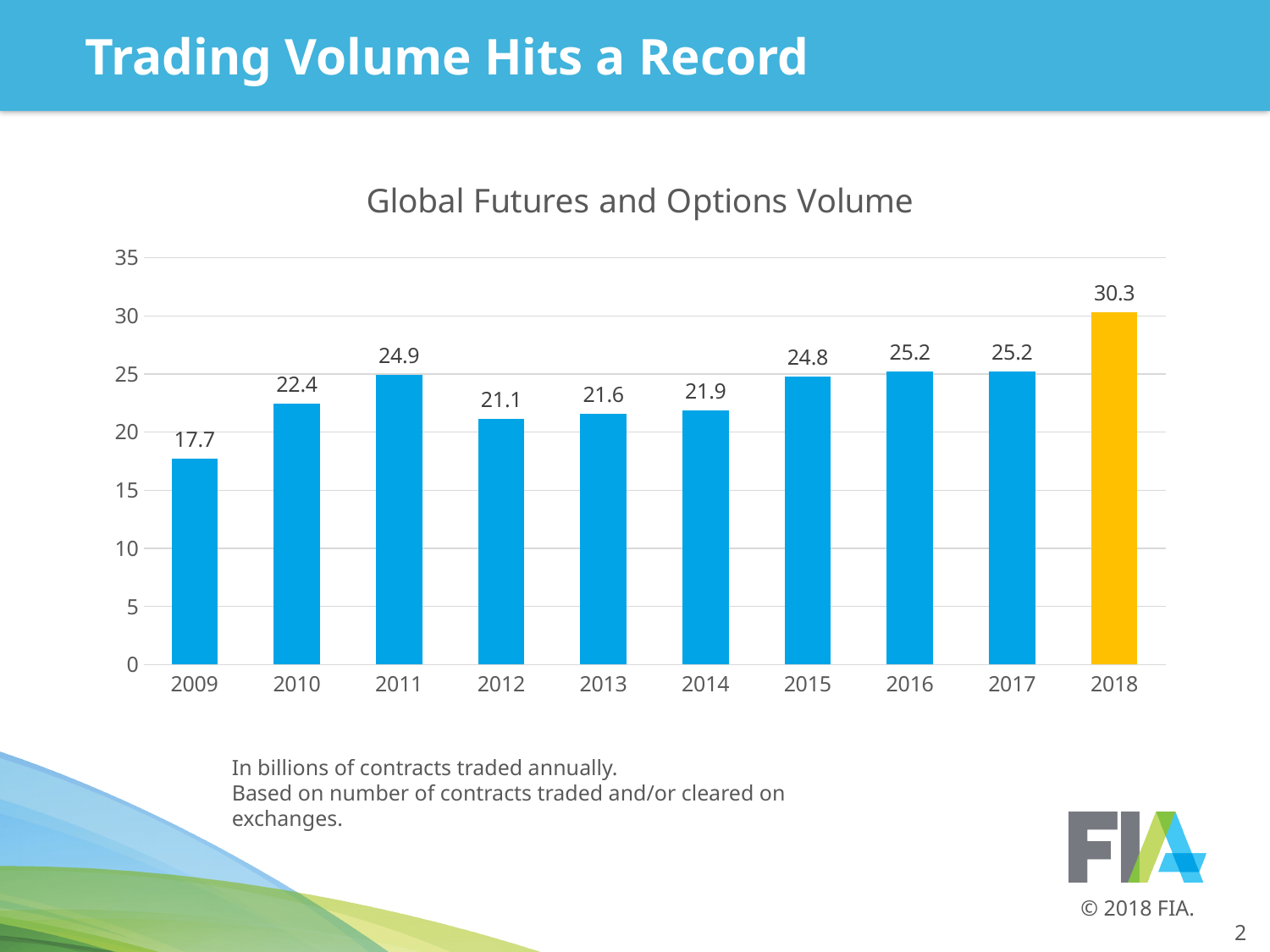
Which year has the highest value in the Global Futures and Options Volume chart? 2018 What kind of chart is the Global Futures and Options Volume chart? bar chart What is the difference between the values for 2011 and 2012 in the Global Futures and Options Volume chart? 3.8 What is the difference between the values for 2018 and 2017 in the Global Futures and Options Volume chart? 5.1 Is the value for 2014 in the Global Futures and Options Volume chart greater or less than 25? less Which year has the lowest value in the Global Futures and Options Volume chart? 2009 Which is larger in the Global Futures and Options Volume chart, the value for 2011 or the value for 2015? 2011 What is the value for 2012 in the Global Futures and Options Volume chart? 21.1 What is the value for 2009 in the Global Futures and Options Volume chart? 17.7 Which bar in the Global Futures and Options Volume chart is coloured differently from the others? 2018 What is the value for 2018 in the Global Futures and Options Volume chart? 30.3 How many years are shown in the Global Futures and Options Volume chart? 10